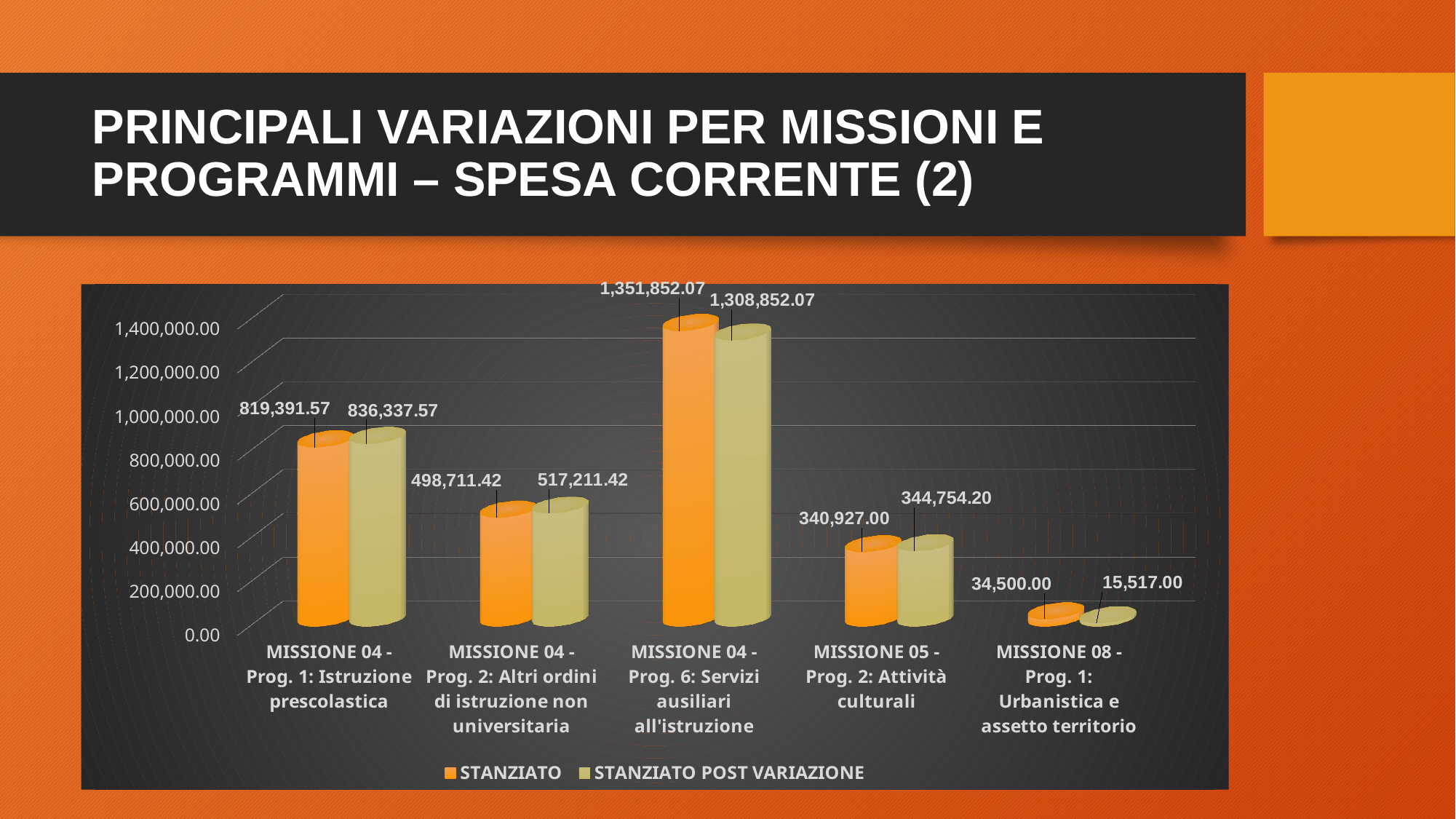
How many categories are shown on the x axis of the chart? 5 What is the STANZIATO POST VARIAZIONE value for MISSIONE 04 - Prog. 2: Altri ordini di istruzione non universitaria? 517,211.42 For MISSIONE 05 - Prog. 2: Attività culturali, which is larger: STANZIATO or STANZIATO POST VARIAZIONE? STANZIATO POST VARIAZIONE For MISSIONE 08 - Prog. 1: Urbanistica e assetto territorio, which is larger: STANZIATO or STANZIATO POST VARIAZIONE? STANZIATO What kind of chart is shown on the slide? Bar chart What is the STANZIATO POST VARIAZIONE value for MISSIONE 08 - Prog. 1: Urbanistica e assetto territorio? 15,517.00 What is the STANZIATO value for MISSIONE 04 - Prog. 1: Istruzione prescolastica? 819,391.57 Which category has the lowest STANZIATO POST VARIAZIONE value? MISSIONE 08 - Prog. 1: Urbanistica e assetto territorio Which category has the highest STANZIATO value? MISSIONE 04 - Prog. 6: Servizi ausiliari all'istruzione How many series does the chart legend list? 2 What is the difference between the STANZIATO and STANZIATO POST VARIAZIONE values for MISSIONE 04 - Prog. 6: Servizi ausiliari all'istruzione? 43,000.00 What is the difference between the STANZIATO POST VARIAZIONE and STANZIATO values for MISSIONE 04 - Prog. 2: Altri ordini di istruzione non universitaria? 18,500.00